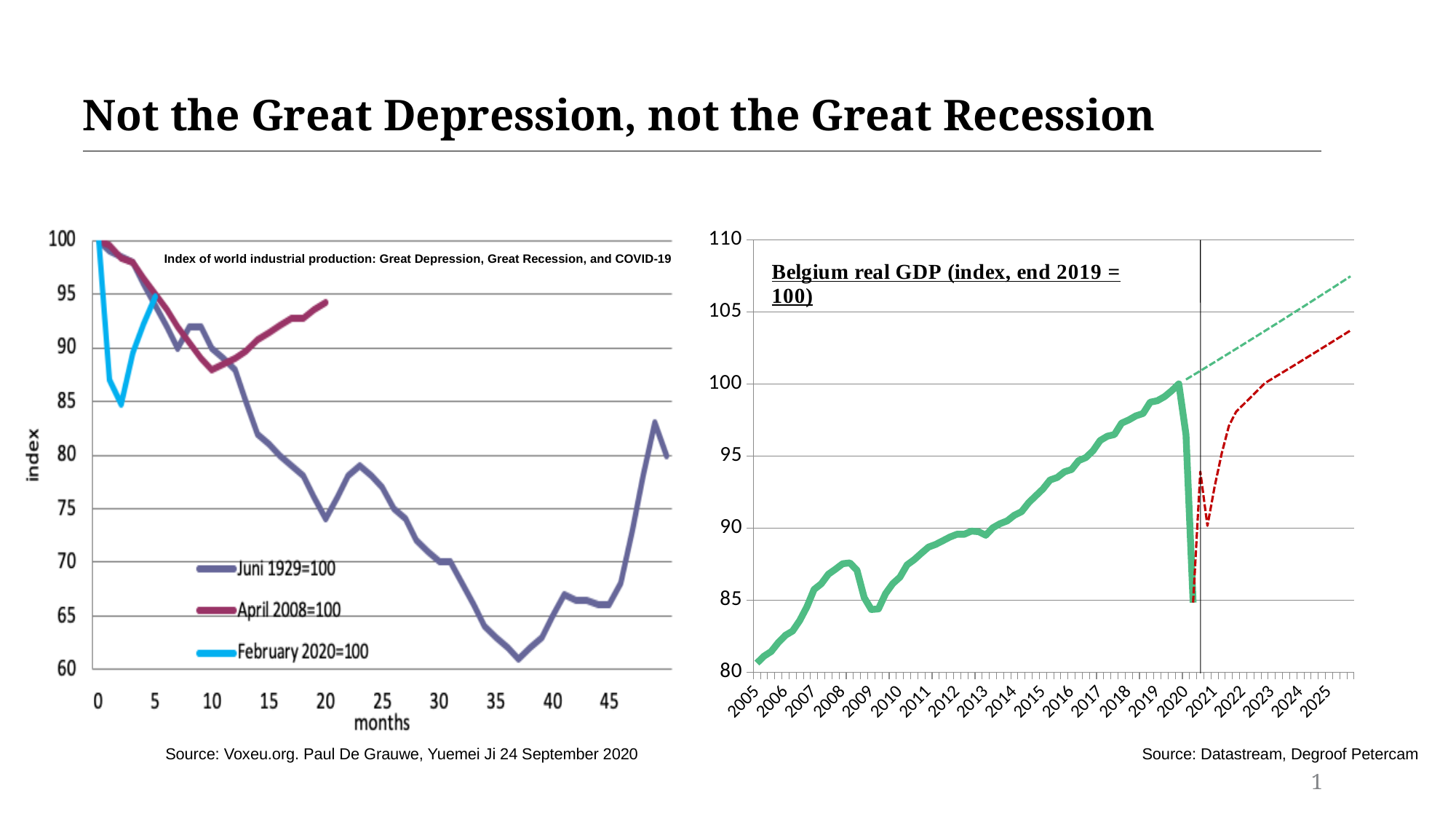
In the left chart, is the lowest value of the February 2020=100 series greater or less than 90? less In the right chart, Belgium real GDP, is the green dashed line at 2025 greater or less than 105? greater How many series does the legend of the left chart list? 3 What is the title of the right chart? Belgium real GDP (index, end 2019 = 100) In the left chart, at month 20, which series has the higher index value: Juni 1929=100 or April 2008=100? April 2008=100 In the right chart, Belgium real GDP, does the index rise or fall overall from 2005 to the end of 2019? rise In the right chart, Belgium real GDP, is the value at the 2020 trough greater or less than 90? less What kind of chart is the left chart, 'Index of world industrial production'? line chart In the left chart, which series falls to the lowest index value? Juni 1929=100